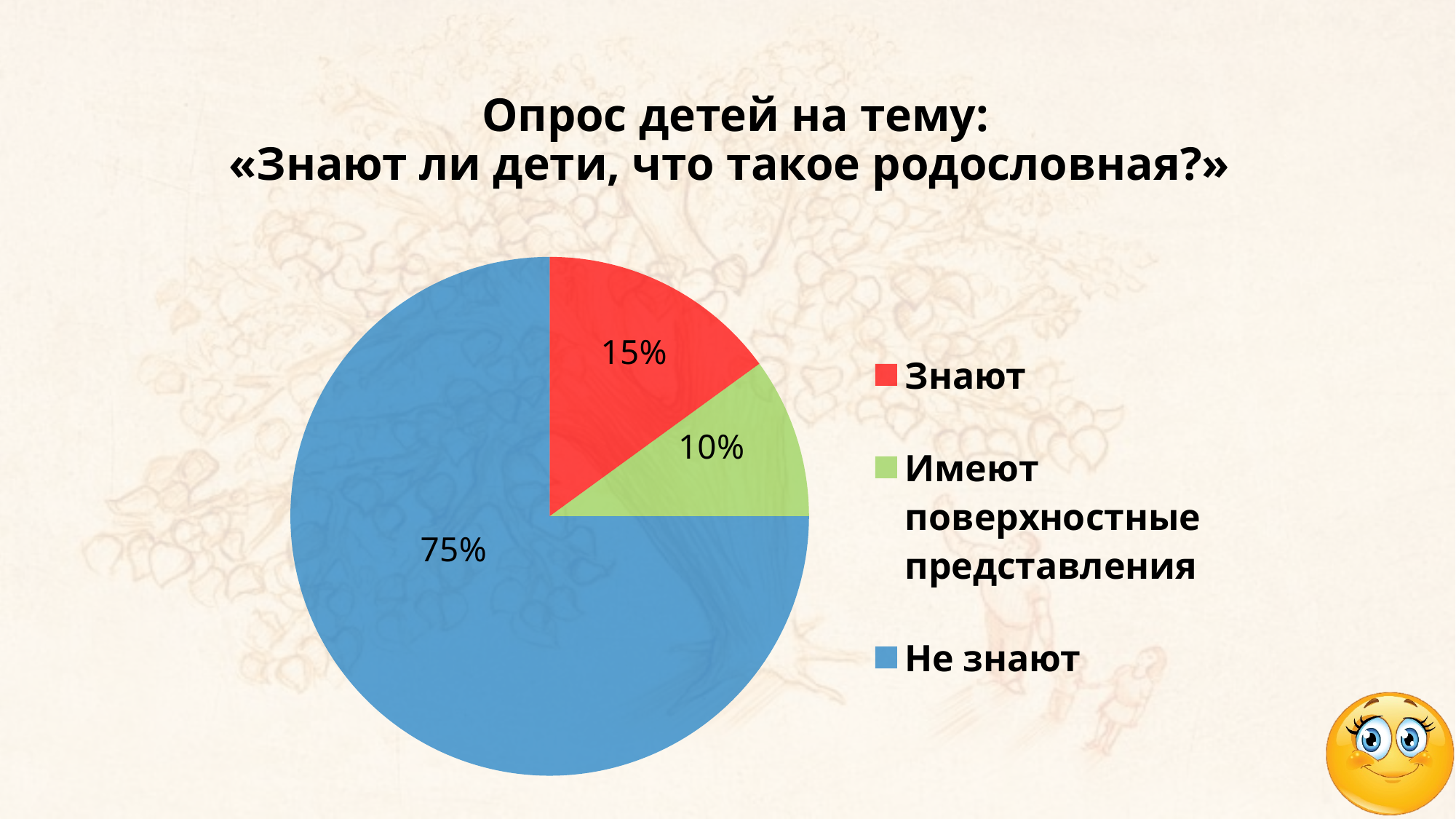
Which is larger: the share for «Знают» or the share for «Имеют поверхностные представления»? Знают What percentage of children answered «Знают»? 15% What is the title of the survey shown on the slide? Опрос детей на тему: «Знают ли дети, что такое родословная?» What is the difference in percentage points between «Знают» and «Имеют поверхностные представления»? 5 What colour is the slice for «Не знают»? Blue What percentage of children «Имеют поверхностные представления»? 10% What kind of chart is shown on the slide? Pie chart What is the difference in percentage points between «Не знают» and «Знают»? 60 How many categories does the pie chart show? 3 What percentage of children answered «Не знают»? 75% Which category has the largest share of the pie? Не знают Which category has the smallest share of the pie? Имеют поверхностные представления